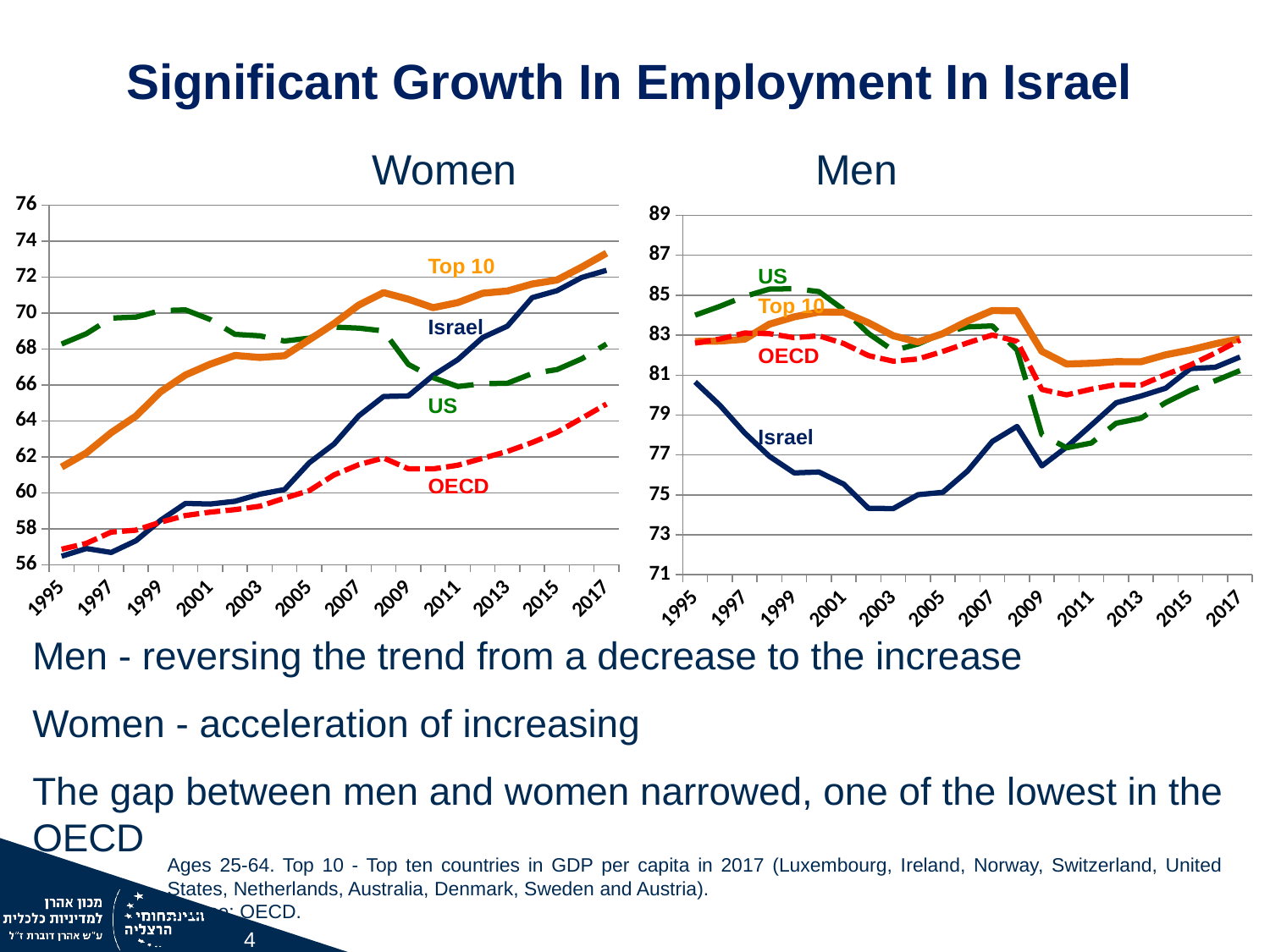
On the Women chart, which series has the highest value in 1995? US On the Men chart, is the value for Israel in 2003 greater or less than 75? less On the Men chart, which is larger in 2001, Israel or OECD? OECD How many series are plotted on the Men chart? 4 What kind of chart is the Women chart? line chart On the Men chart, which series has the lowest value in 2003? Israel On the Women chart, is the value for Israel in 2017 greater or less than 70? greater On the Men chart, is the value for Israel in 2017 greater or less than 81? greater On the Women chart, does the Israel line rise or fall from 1995 to 2017? rise What is the first year shown on the x axis of the Men chart? 1995 On the Women chart, which series has the lowest value in 2017? OECD